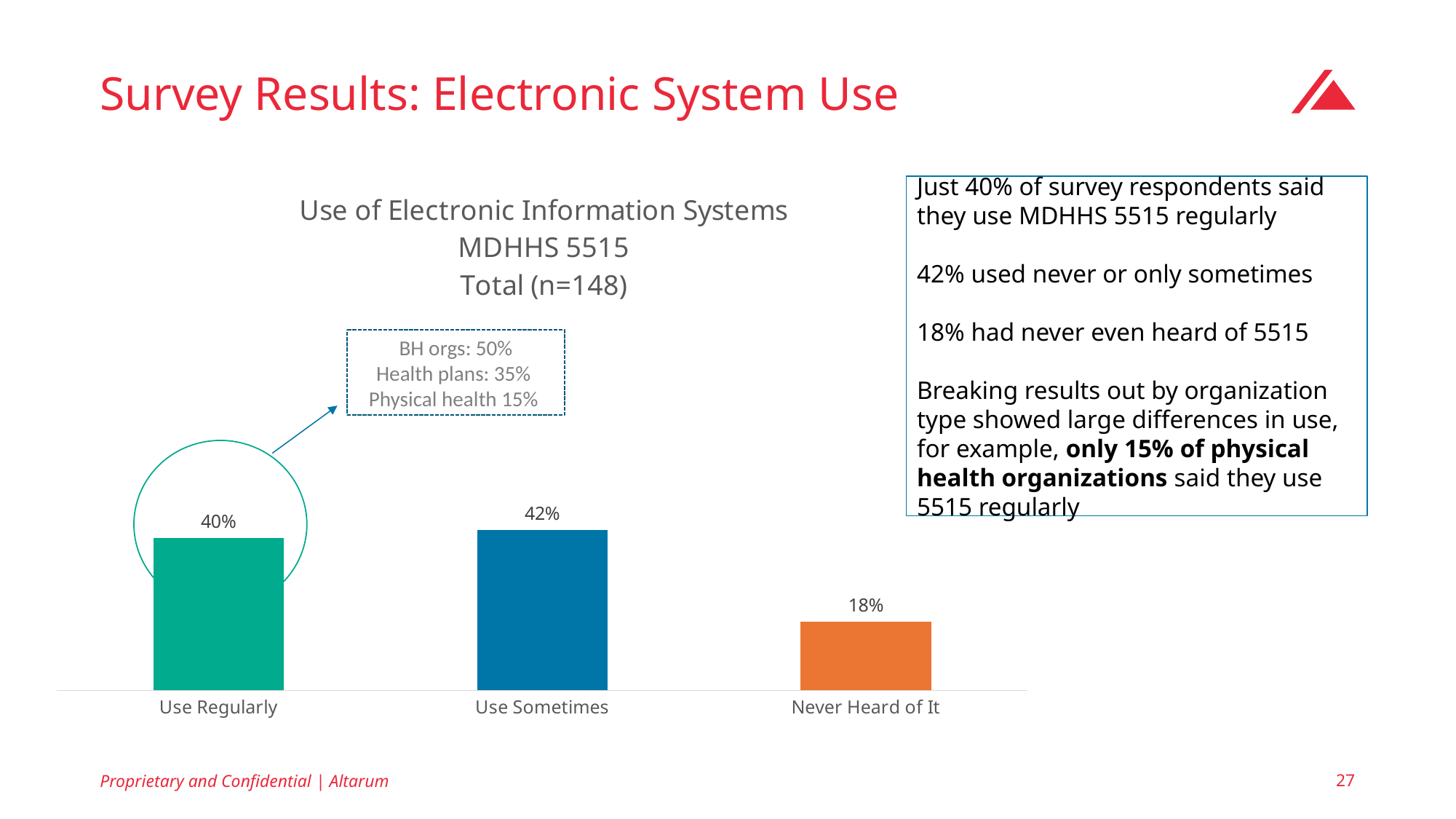
What is the value for Never Heard of It? 18% What is the difference between the values for Use Regularly and Never Heard of It? 22% What kind of chart is shown on the slide? Bar chart What is the value for Use Regularly? 40% Which category has the lowest value? Never Heard of It Which category has the highest value? Use Sometimes What is the value for Use Sometimes? 42% What colour is the bar for Never Heard of It? Orange What is the difference between the values for Use Sometimes and Never Heard of It? 24% What is the sample size (n) given in the chart title? 148 Which is larger, the value for Use Regularly or the value for Never Heard of It? Use Regularly How many categories are shown in the chart? 3